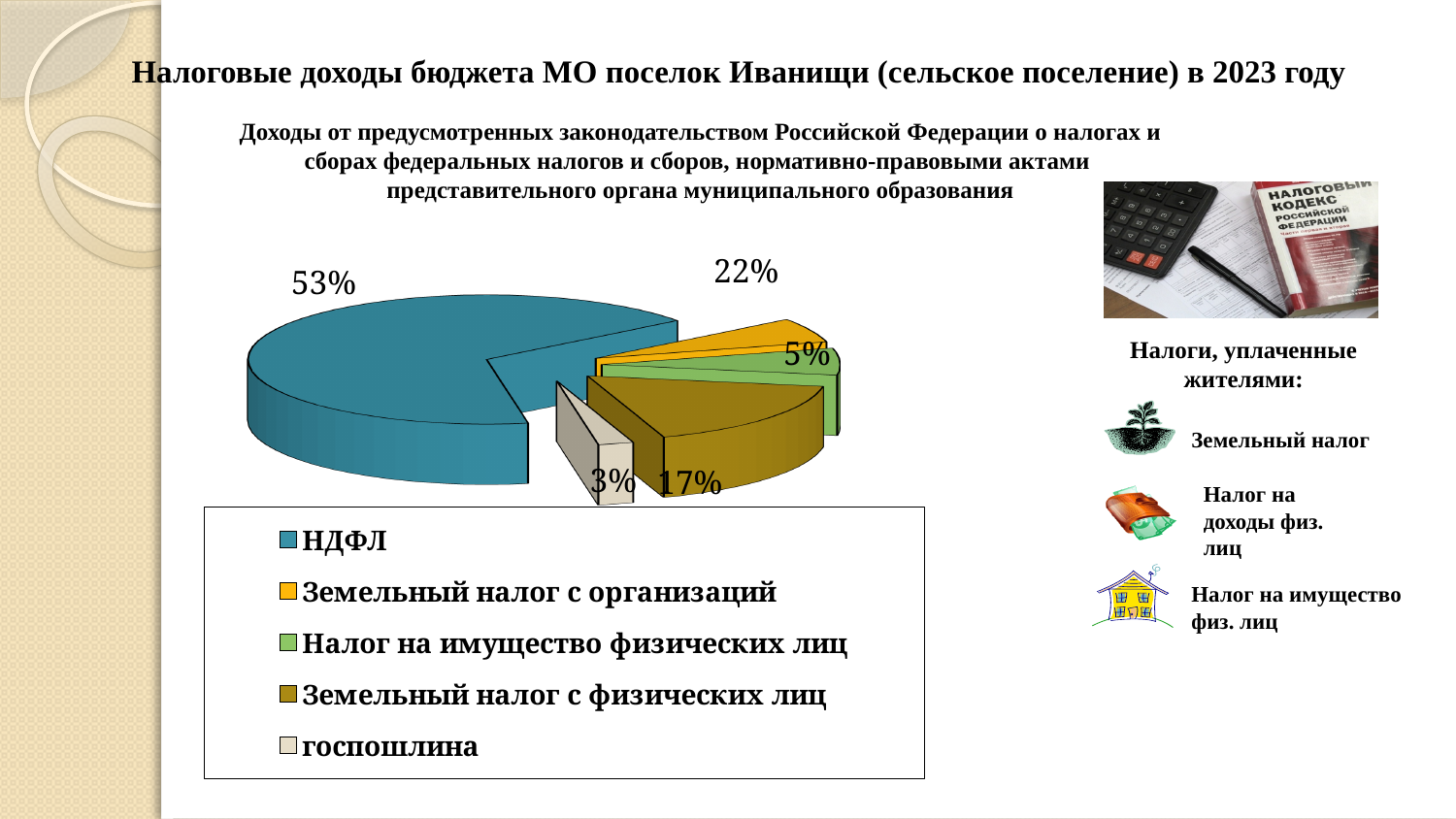
What share of the pie does Налог на имущество физических лиц account for? 5% Which category has the largest slice of the pie? НДФЛ Which is larger: Земельный налог с физических лиц or Налог на имущество физических лиц? Земельный налог с физических лиц What share of the pie does Земельный налог с организаций account for? 22% What kind of chart is shown on the slide? pie chart How many slices does the pie chart have? 5 Which category has the smallest slice of the pie? госпошлина What share of the pie does НДФЛ account for? 53% What colour is the НДФЛ slice in the pie chart? blue What share of the pie does госпошлина account for? 3% What is the difference in percentage points between НДФЛ and Земельный налог с организаций? 31 What share of the pie does Земельный налог с физических лиц account for? 17%